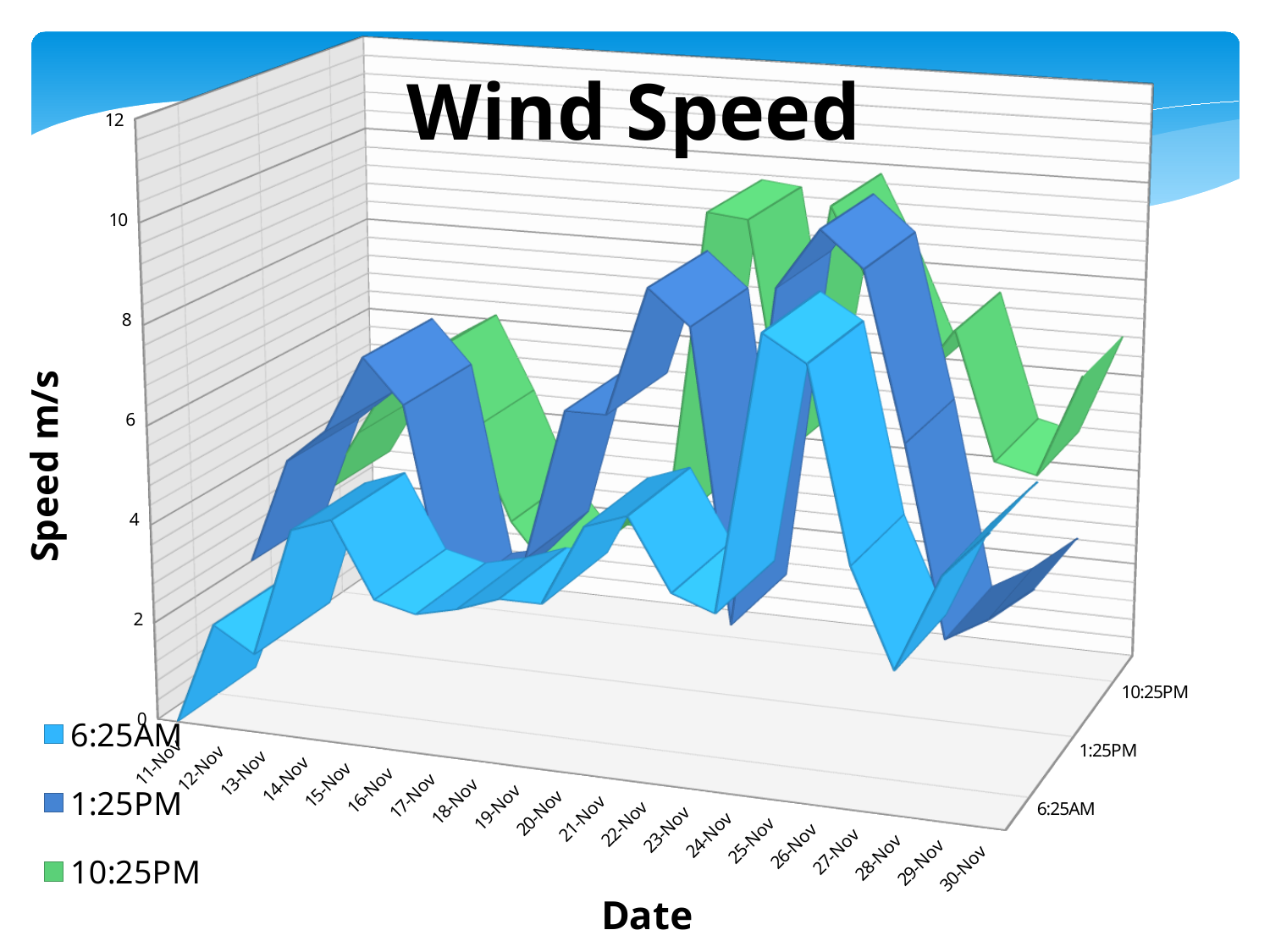
How many series does the legend list? 3 What is the first date shown on the x axis? 11-Nov What kind of chart is shown on the slide? 3D line chart What is the highest tick value shown on the vertical axis? 12 Which series is listed first in the legend? 6:25AM What is the label of the vertical axis? Speed m/s Is the value for the 6:25AM series on 11-Nov greater or less than 2? less What is the last date shown on the x axis? 30-Nov How many dates are plotted along the x axis? 20 What is the title of the chart? Wind Speed